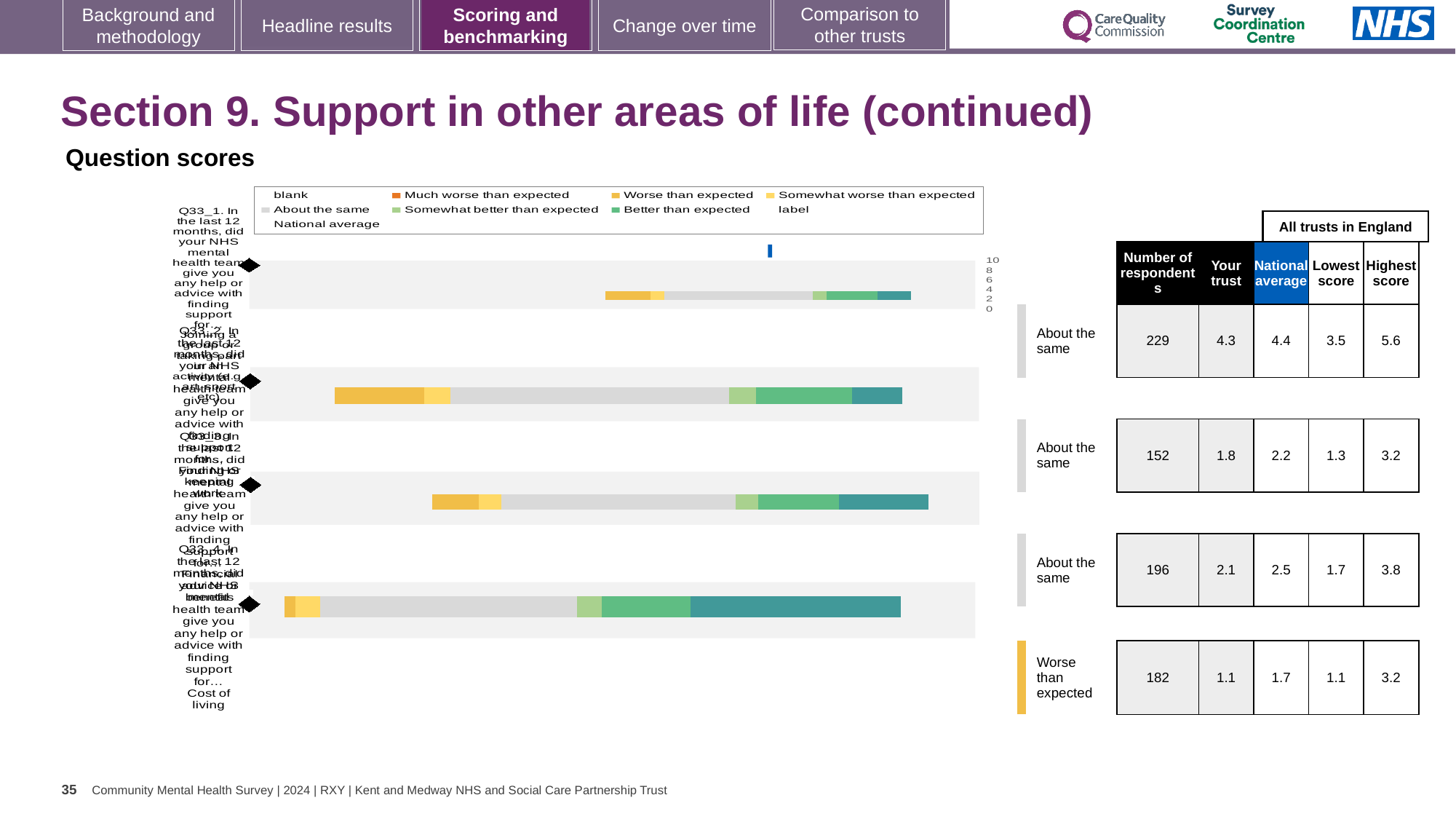
What benchmark label is given to the Cost of living question? Worse than expected How many question bars are plotted in the chart? 4 What kind of chart is used to show the question scores on this slide? Bar chart Which question has the lowest 'Your trust' score? Cost of living (Q33_4) What is the difference between the national average and the 'Your trust' score for the first question (Q33_1)? 0.1 What colour represents 'Worse than expected' in the chart legend? Orange-yellow How many of the four questions are labelled 'About the same'? 3 Which question has the highest 'Your trust' score? Q33_1 (first row) For the third question (Q33_3), which is larger: the 'Your trust' score or the national average? National average What is the 'Your trust' score for the Cost of living question? 1.1 What is the number of respondents for the first question (Q33_1) in the table? 229 What is the highest score across all trusts in England for the second question (Q33_2)? 3.2